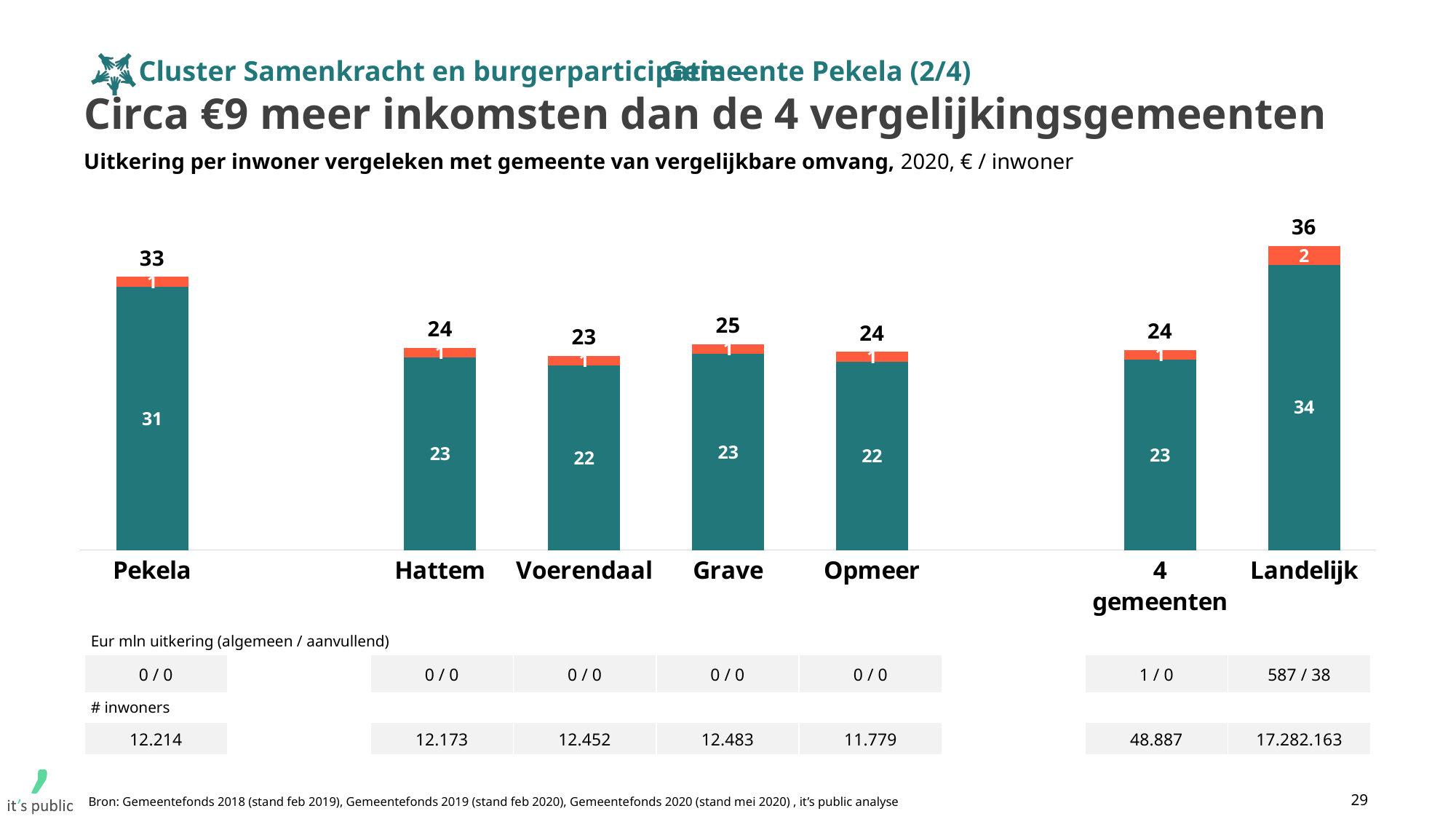
Which category has the highest total value? Landelijk What is the difference between the total for Pekela and the total for 4 gemeenten? 9 What is the value of the teal (lower) segment of the Landelijk bar? 34 Which has a larger total value, Pekela or Hattem? Pekela What is the difference between the total for Landelijk and the total for Pekela? 3 What is the total value shown above the bar for Pekela? 33 What is the value of the orange (upper) segment of the Landelijk bar? 2 What is the total value shown above the bar for Grave? 25 Which category has the lowest total value? Voerendaal What is the value of the teal (lower) segment of the Voerendaal bar? 22 What kind of chart is shown on the slide? Stacked bar chart How many categories (bars) are shown in the chart? 7